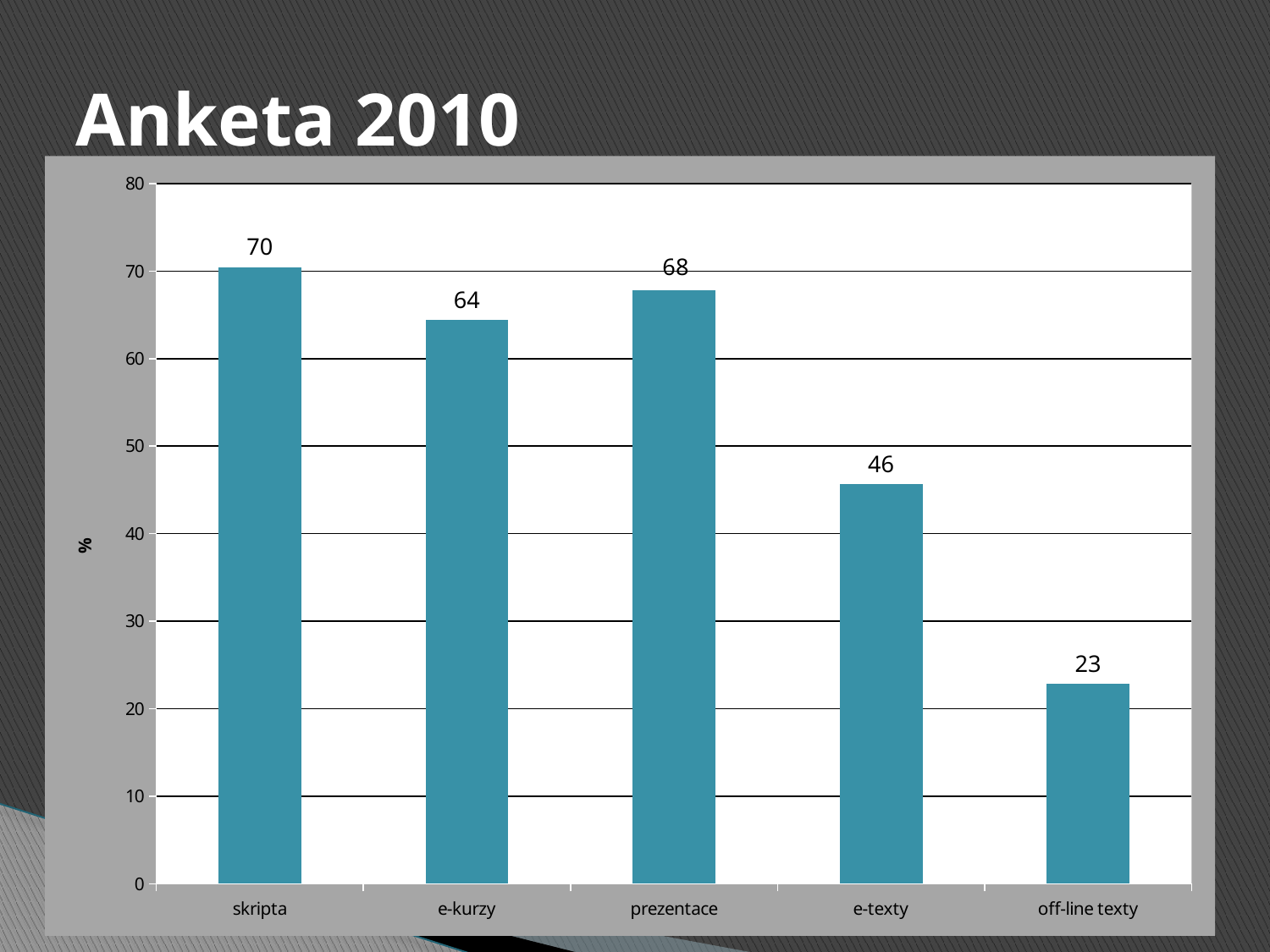
What kind of chart is shown on the slide? bar chart What is the title of the slide? Anketa 2010 Which category has the highest value? skripta What is the label of the vertical axis? % What is the difference between the values for prezentace and e-texty? 22 Is the value for e-texty greater or less than 50? less What is the value for skripta? 70 What is the value for off-line texty? 23 How many categories are shown on the x axis? 5 Which category has the lowest value? off-line texty Which is larger, the value for e-kurzy or the value for e-texty? e-kurzy What is the value for e-kurzy? 64